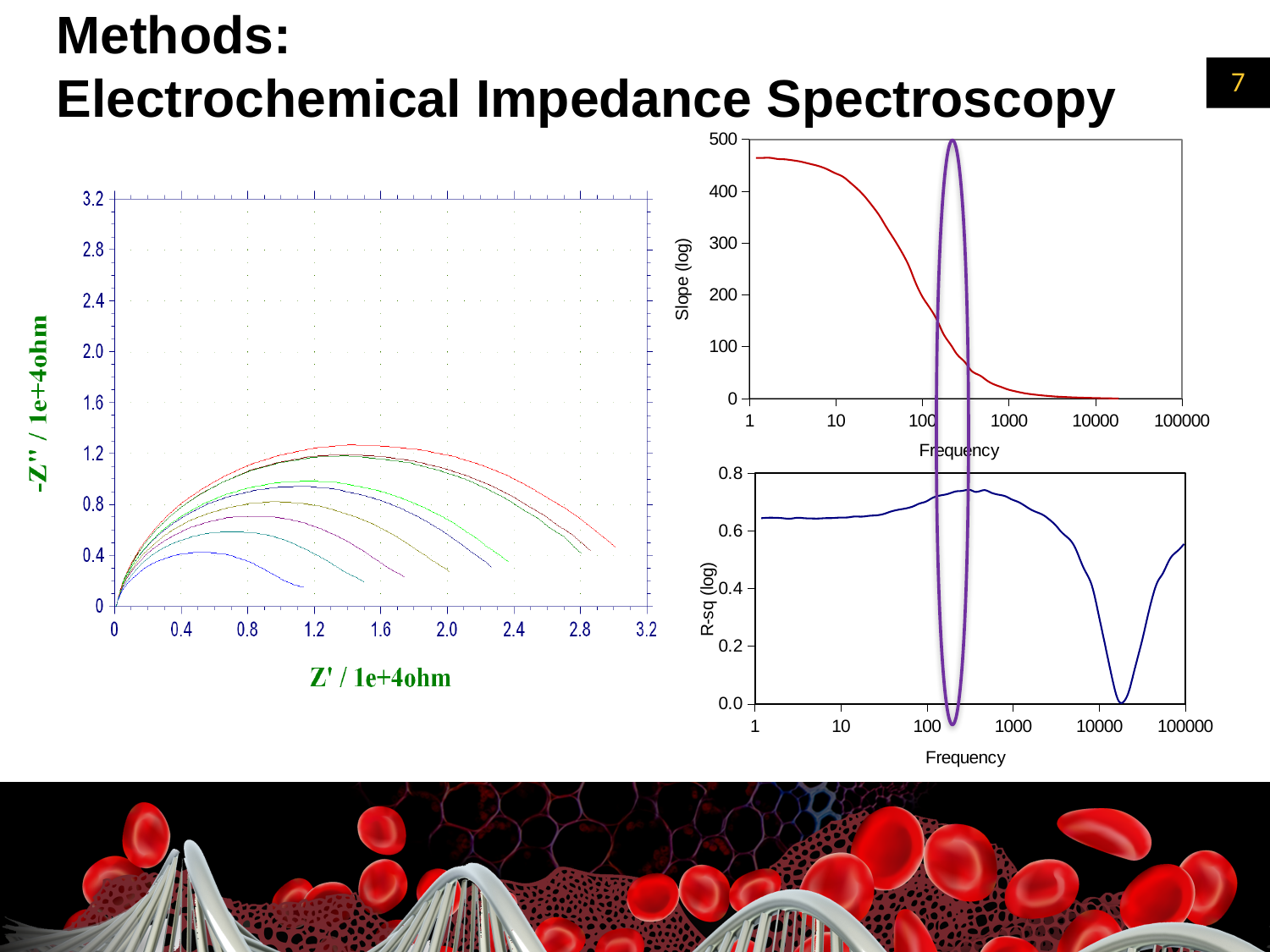
In the top-right 'Slope (log)' chart, is the value at frequency 1000 greater or less than 100? less What kind of chart is the left chart with axes Z' and -Z''? line chart What is the x-axis label of the left chart? Z' / 1e+4ohm In the bottom-right 'R-sq (log)' chart, is the highest point of the curve greater or less than 0.8? less What kind of chart is the top-right chart with y axis 'Slope (log)'? line chart In the bottom-right 'R-sq (log)' chart, is the lowest point of the curve greater or less than 0.2? less In the top-right 'Slope (log)' chart, does the slope rise or fall as frequency increases? fall What is the x-axis label of the two charts on the right side of the slide? Frequency In the bottom-right 'R-sq (log)' chart, does the curve rise or fall between frequency 1000 and 10000? fall